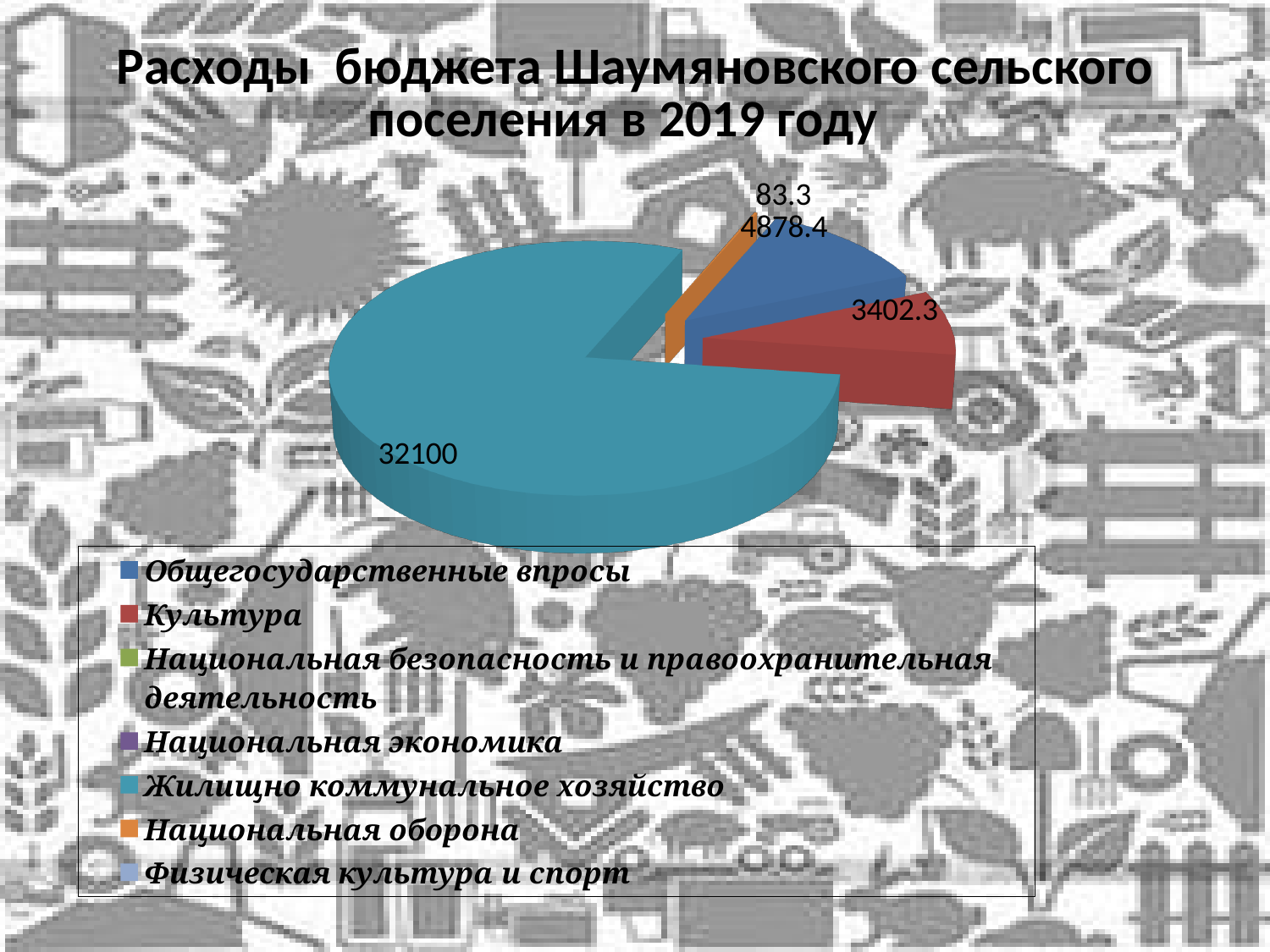
Among the labeled slices, which category has the smallest value? Национальная оборона What is the value shown for Общегосударственные впросы? 4878.4 What is the title of the chart? Расходы бюджета Шаумяновского сельского поселения в 2019 году How many categories does the legend list? 7 What is the value shown for Жилищно коммунальное хозяйство? 32100 Which category has the largest slice of the pie? Жилищно коммунальное хозяйство What is the value shown for Культура? 3402.3 What is the difference between the values for Жилищно коммунальное хозяйство and Общегосударственные впросы? 27221.6 What kind of chart is shown on the slide? Pie chart Which is larger, the value for Культура or the value for Общегосударственные впросы? Общегосударственные впросы What is the difference between the values for Общегосударственные впросы and Культура? 1476.1 What is the value shown for Национальная оборона? 83.3